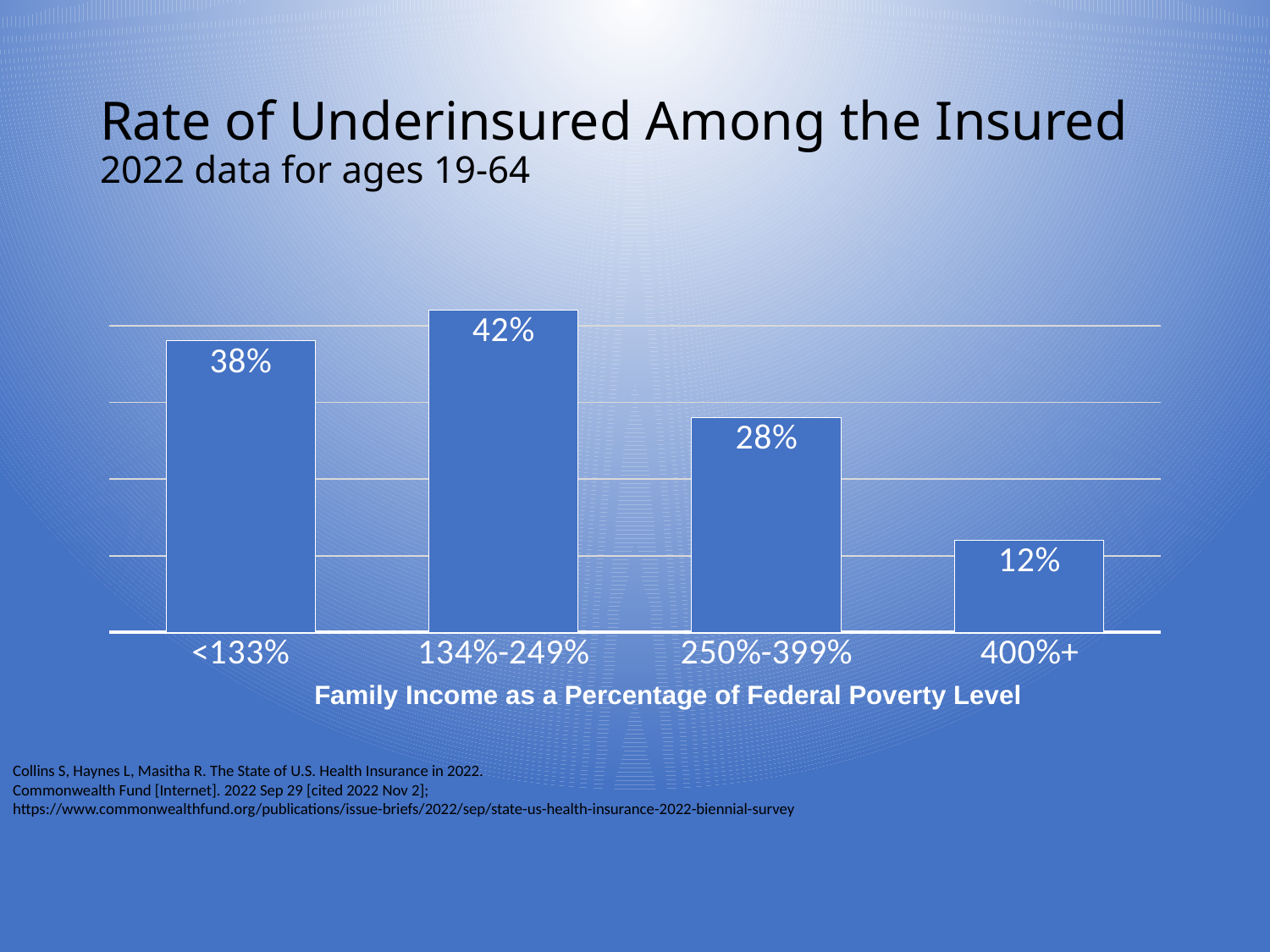
Which family income group has the lowest rate of underinsured? 400%+ How many family income groups are shown in the chart? 4 Which has a higher rate of underinsured, the <133% group or the 250%-399% group? <133% What is the difference between the underinsured rates for the <133% and 250%-399% groups? 10% What kind of chart is shown on the slide? Bar chart What is the rate of underinsured for the <133% family income group? 38% Which family income group has the highest rate of underinsured? 134%-249% What is the rate of underinsured for the 134%-249% family income group? 42% What is the difference between the underinsured rates for the 134%-249% and 400%+ groups? 30% What is the rate of underinsured for the 250%-399% family income group? 28% What is the rate of underinsured for the 400%+ family income group? 12% What is the x-axis title of the chart? Family Income as a Percentage of Federal Poverty Level